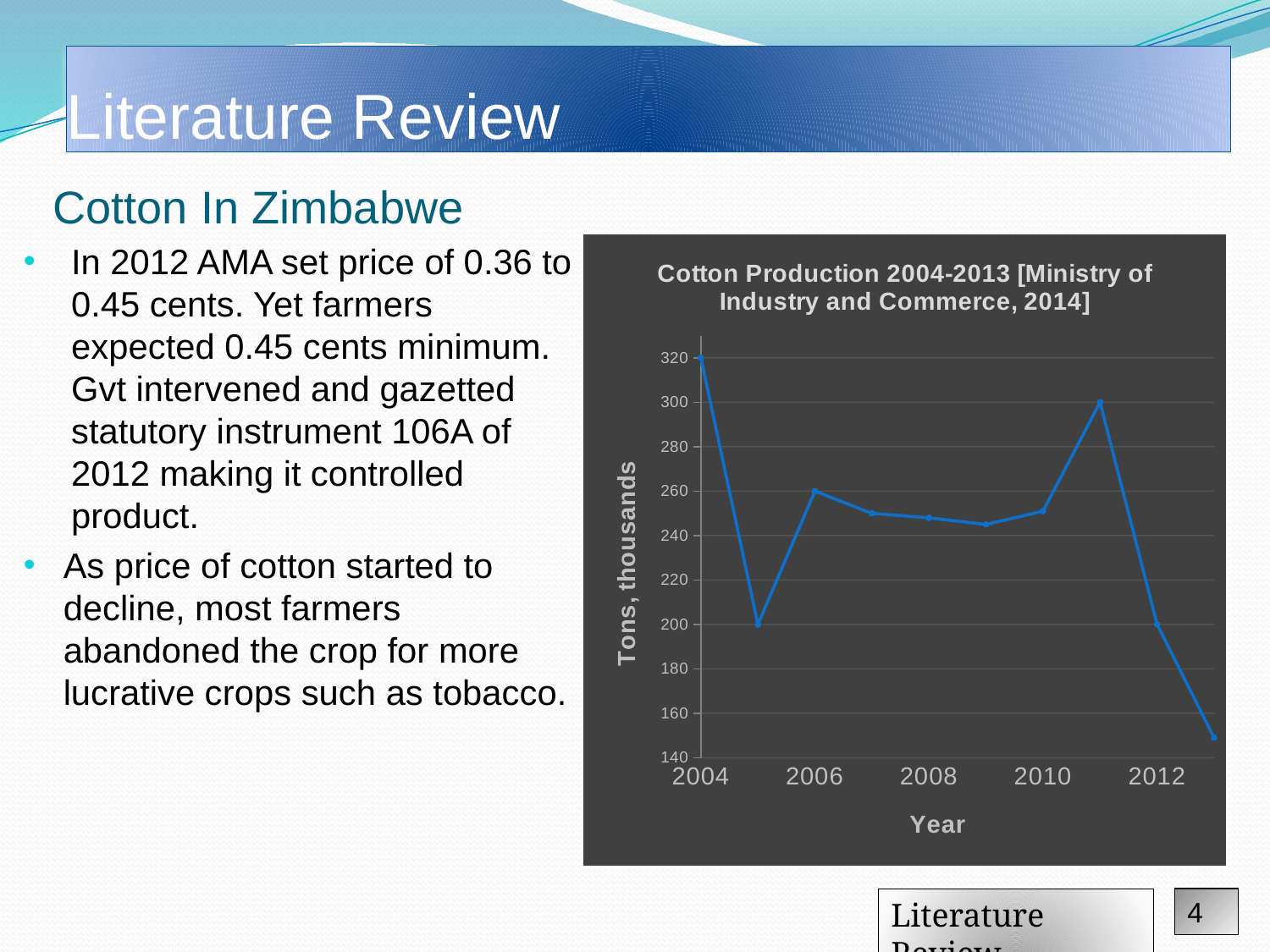
What is the cotton production value for 2004? 320 What is the cotton production value for 2005? 200 Which year has the highest cotton production? 2004 What is the label of the y axis? Tons, thousands What kind of chart is shown on the slide? line chart Which year has the lowest cotton production? 2013 What is the cotton production value for 2011? 300 Is the cotton production value for 2013 greater or less than 160? less What is the cotton production value for 2006? 260 Which year has higher cotton production, 2004 or 2011? 2004 What is the difference in cotton production between 2004 and 2005? 120 How many years are plotted on the chart? 10